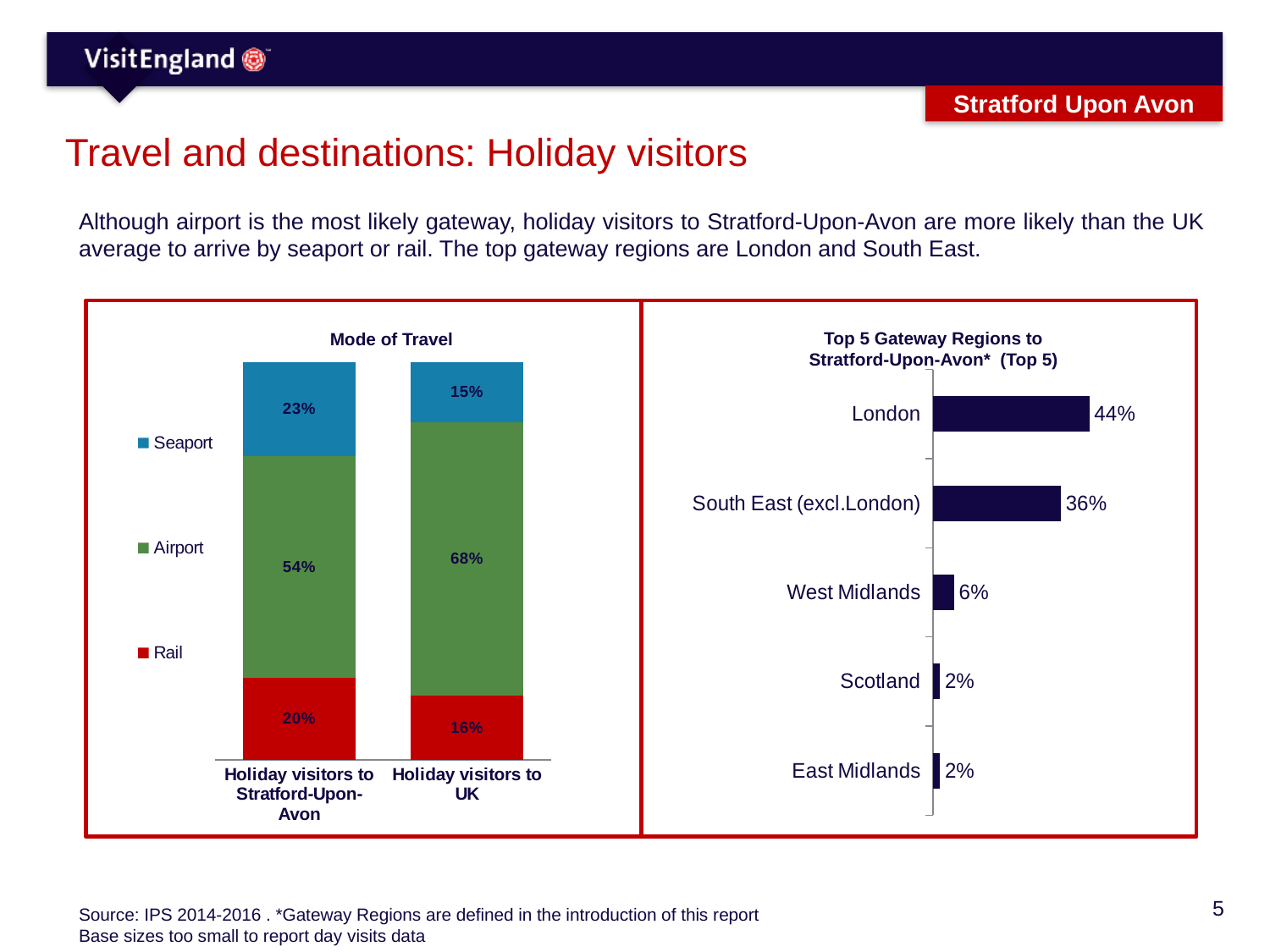
In the Top 5 Gateway Regions chart, what is the difference between London and West Midlands? 38 percentage points In the Mode of Travel chart, which colour represents Rail? Red In the Mode of Travel chart, which is larger: the seaport share for holiday visitors to Stratford-Upon-Avon or for holiday visitors to the UK? Holiday visitors to Stratford-Upon-Avon In the Top 5 Gateway Regions chart, what is the value for Scotland? 2% How many series does the legend of the Mode of Travel chart list? 3 In the Mode of Travel chart, what percentage of holiday visitors to Stratford-Upon-Avon arrive by seaport? 23% In the Mode of Travel chart, what is the difference between the rail share for holiday visitors to Stratford-Upon-Avon and for holiday visitors to the UK? 4 percentage points In the Top 5 Gateway Regions chart, what is the value for South East (excl.London)? 36% How many regions are shown in the Top 5 Gateway Regions chart? 5 In the Top 5 Gateway Regions chart, which region has the highest value? London What kind of chart is the Mode of Travel chart? Stacked bar chart In the Mode of Travel chart, what percentage of holiday visitors to the UK arrive by airport? 68%